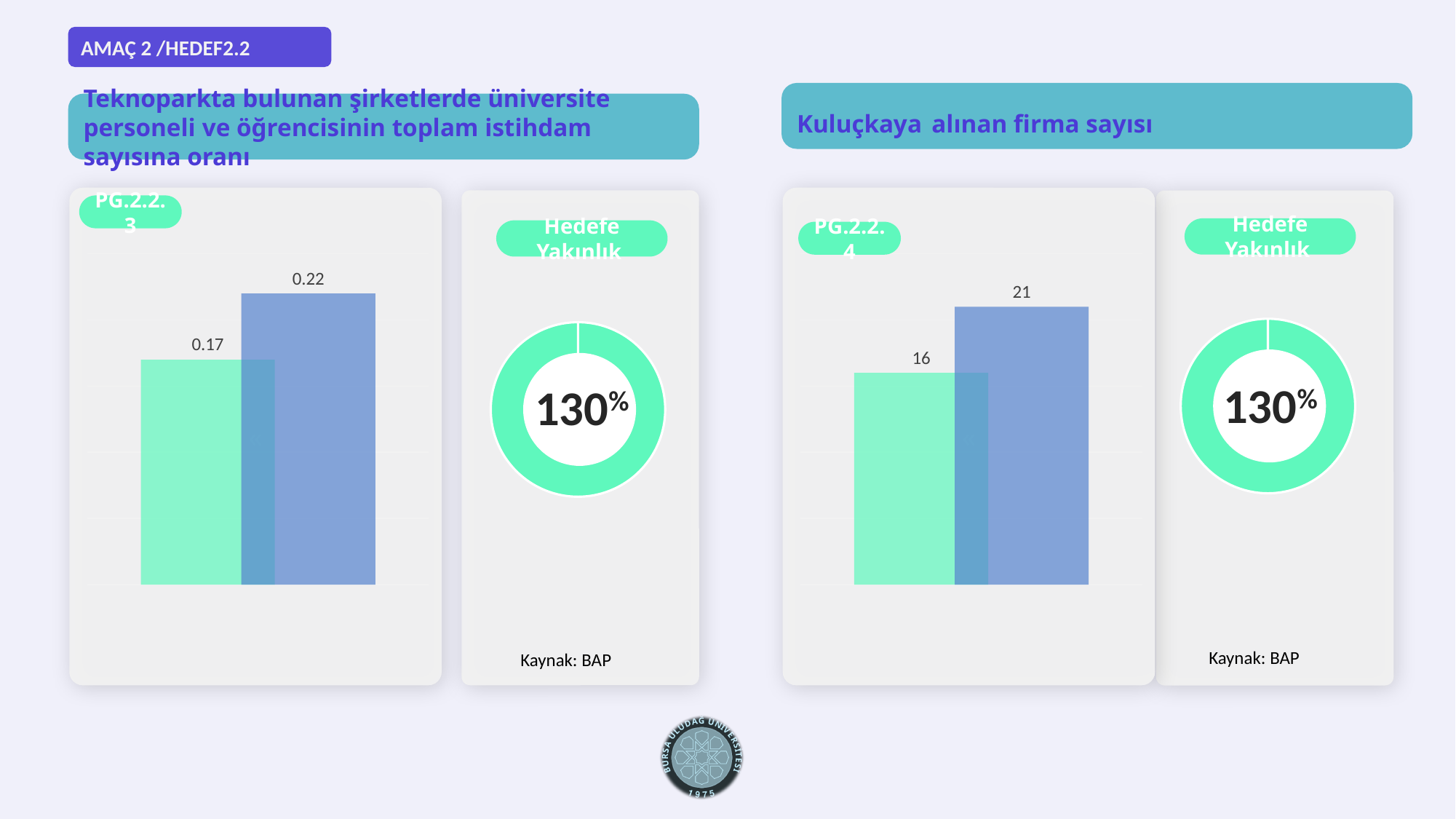
In the PG.2.2.3 bar chart on the left, what value is printed above the green bar? 0.17 In the PG.2.2.4 bar chart on the right, what value is printed above the blue bar? 21 In the PG.2.2.4 bar chart on the right, which bar has the lowest value? the green bar In the PG.2.2.3 bar chart on the left, which bar is taller, the green one or the blue one? the blue one In the PG.2.2.4 bar chart on the right, what is the difference between the two bar values? 5 What source is cited below the 'Hedefe Yakınlık' donut chart on the left? Kaynak: BAP In the PG.2.2.3 bar chart on the left, what is the difference between the two bar values? 0.05 In the PG.2.2.4 bar chart on the right, what value is printed above the green bar? 16 What kind of chart is used under the PG.2.2.3 label on the left? bar chart How many bars are shown in the PG.2.2.4 bar chart on the right? 2 What percentage is shown in the 'Hedefe Yakınlık' donut chart next to the PG.2.2.4 bar chart? 130% In the PG.2.2.3 bar chart on the left, what value is printed above the blue bar? 0.22